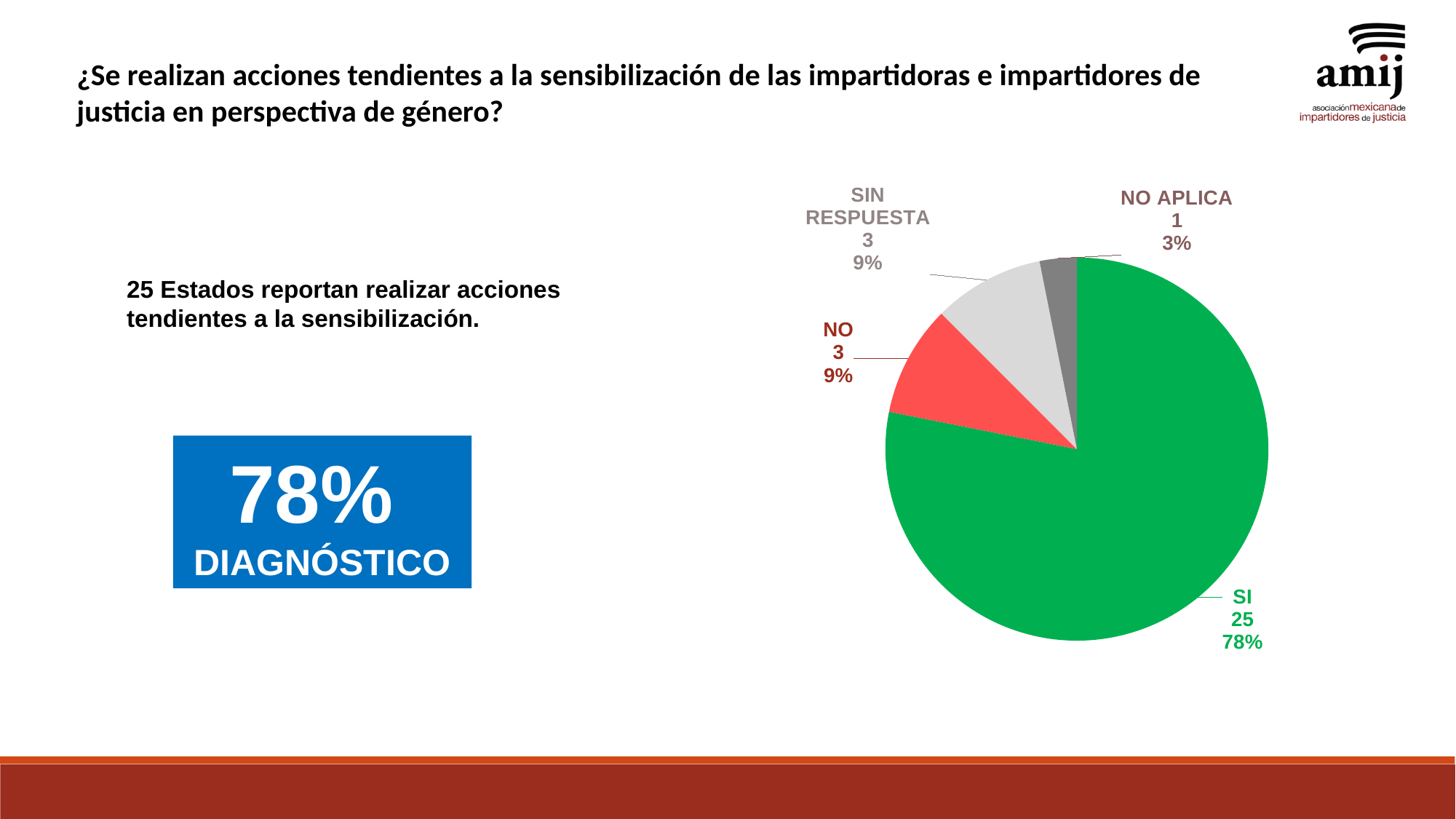
How many slices does the pie chart have? 4 Which slice is the largest? SI What colour is the SI slice? green What is the count for the NO slice? 3 What percentage share does the NO APLICA slice have? 3% What percentage share does the SI slice have? 78% What is the count for the SI slice? 25 What kind of chart is shown on the slide? pie chart Which slice is the smallest? NO APLICA What is the difference in count between SI and NO? 22 What is the count for the SIN RESPUESTA slice? 3 Which is larger, the NO slice or the NO APLICA slice? NO